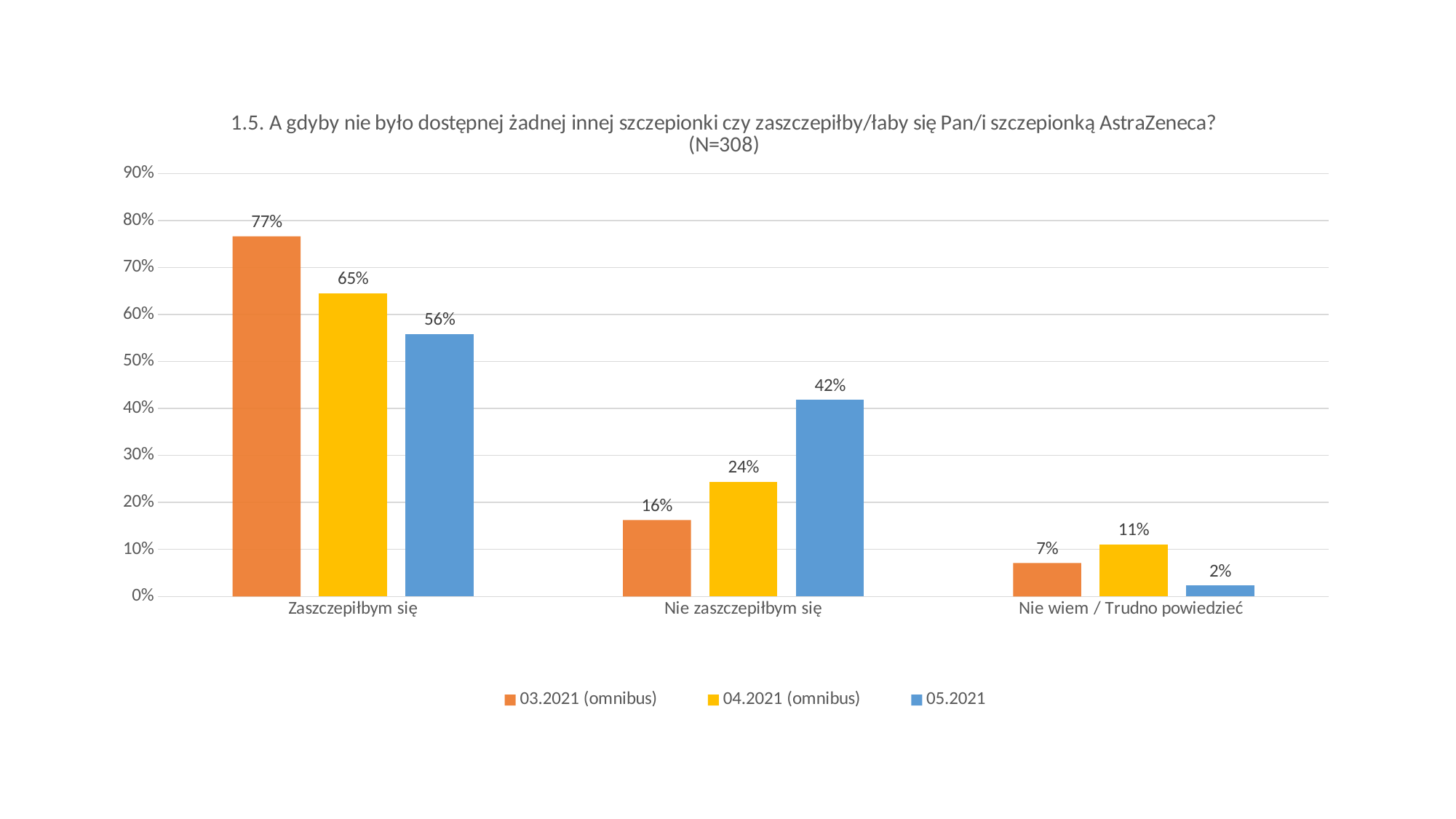
What kind of chart is shown on the slide? bar chart How many categories are shown on the x axis? 3 How many series does the legend list? 3 Which category has the highest value in the 05.2021 series? Zaszczepiłbym się What is the sample size (N) stated in the chart title? N=308 Which series has the larger value for 'Nie zaszczepiłbym się': 04.2021 (omnibus) or 05.2021? 05.2021 Which category has the lowest value in the 03.2021 (omnibus) series? Nie wiem / Trudno powiedzieć What is the value for 'Nie zaszczepiłbym się' in the 05.2021 series? 42% What is the difference between the 03.2021 (omnibus) and 05.2021 values for 'Zaszczepiłbym się'? 21% Is the value for 'Zaszczepiłbym się' in the 04.2021 (omnibus) series greater or less than 60%? greater What is the value for 'Zaszczepiłbym się' in the 03.2021 (omnibus) series? 77% What is the value for 'Nie wiem / Trudno powiedzieć' in the 04.2021 (omnibus) series? 11%